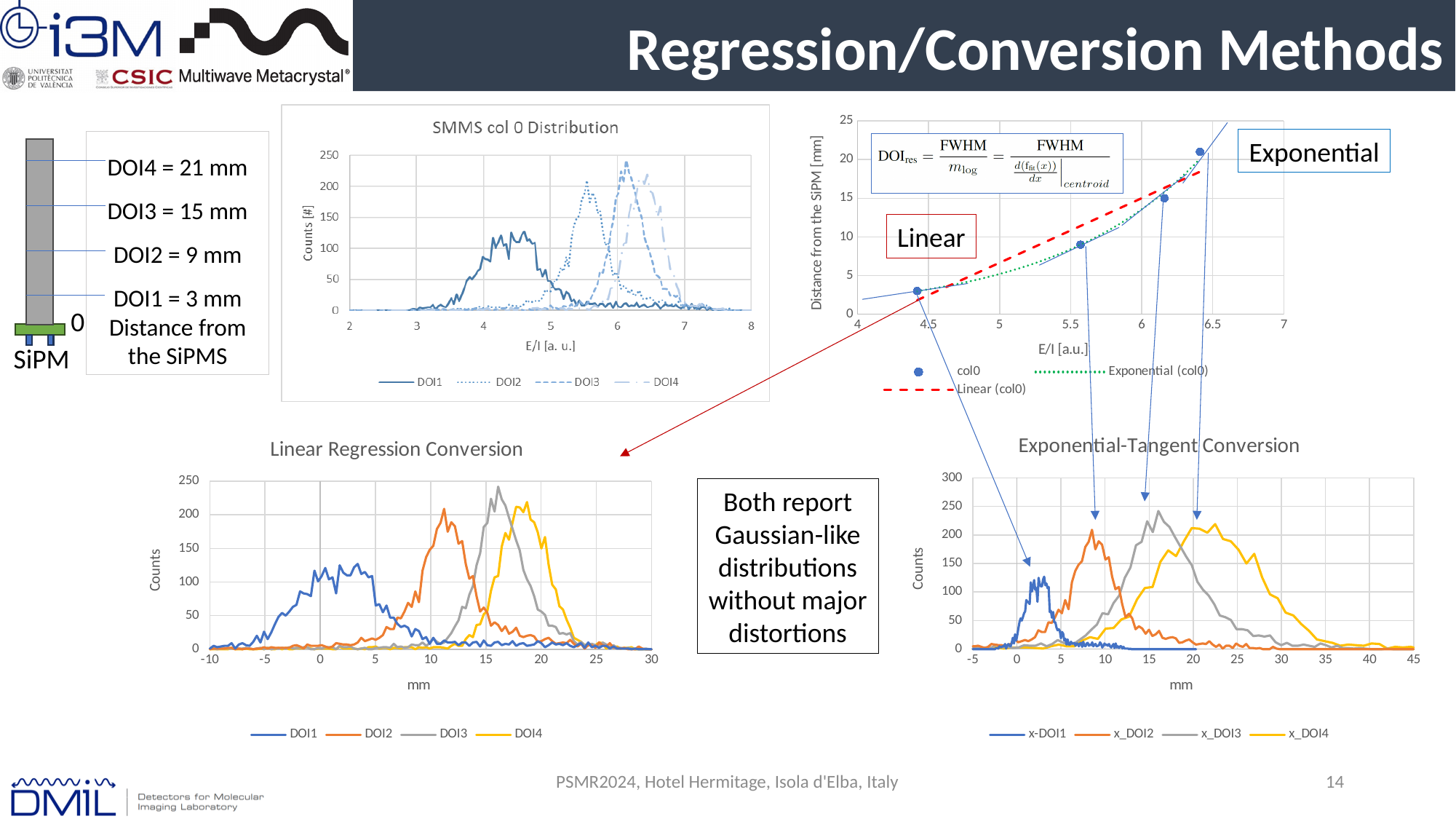
How many series does the legend of the 'Exponential-Tangent Conversion' chart list? 4 In the 'SMMS col 0 Distribution' chart, is the peak of DOI1 greater or less than 150? less In the 'Exponential-Tangent Conversion' chart, is the peak of x-DOI1 greater or less than 150? less In the 'Linear Regression Conversion' chart, is the peak of DOI3 greater or less than 200? greater In the 'Linear Regression Conversion' chart, which series has the lowest peak? DOI1 How many series does the legend of the 'SMMS col 0 Distribution' chart list? 4 What kind of chart is the 'SMMS col 0 Distribution' chart? line chart In the 'SMMS col 0 Distribution' chart, which series has the lowest peak? DOI1 What is the y-axis label of the top-right regression chart? Distance from the SiPM [mm] How many entries does the legend of the top-right regression chart list? 3 How many data points (col0 markers) are plotted in the top-right regression chart? 4